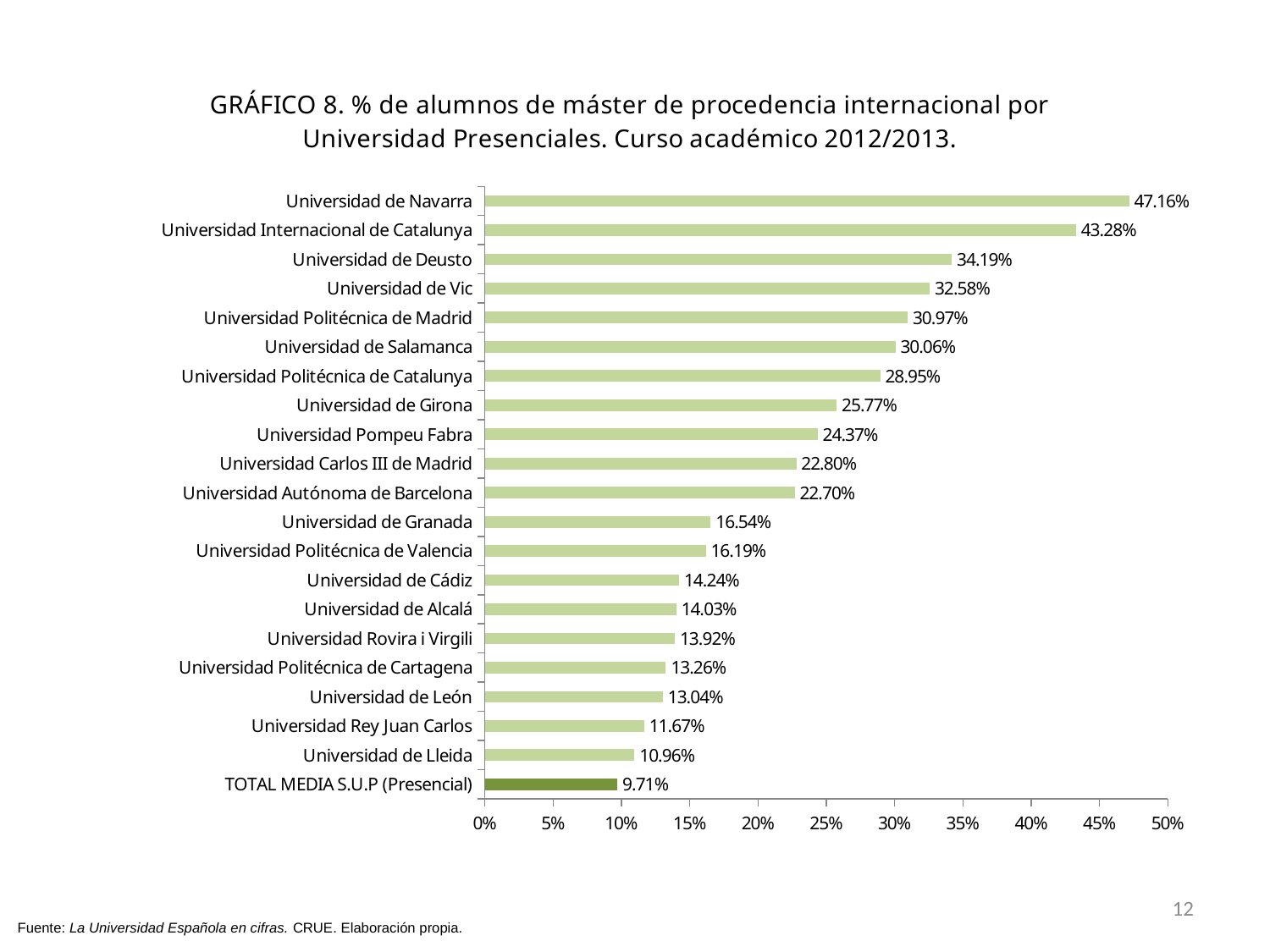
How many categories (bars) are shown in the chart? 21 What is the value for Universidad de Salamanca? 30.06% Which category has the lowest value in the chart? TOTAL MEDIA S.U.P (Presencial) Which is larger, the value for Universidad de Deusto or Universidad de Vic? Universidad de Deusto Is the value for Universidad de Girona greater or less than 25%? greater Which university has the highest percentage of international master's students? Universidad de Navarra What is the value for Universidad Politécnica de Cartagena? 13.26% What is the difference between the values for Universidad de Navarra and Universidad Internacional de Catalunya? 3.88% What is the value for Universidad de Navarra? 47.16% What is the value for TOTAL MEDIA S.U.P (Presencial)? 9.71% What kind of chart is shown on the slide? Bar chart Which bar is shown in a darker green colour than the others? TOTAL MEDIA S.U.P (Presencial)